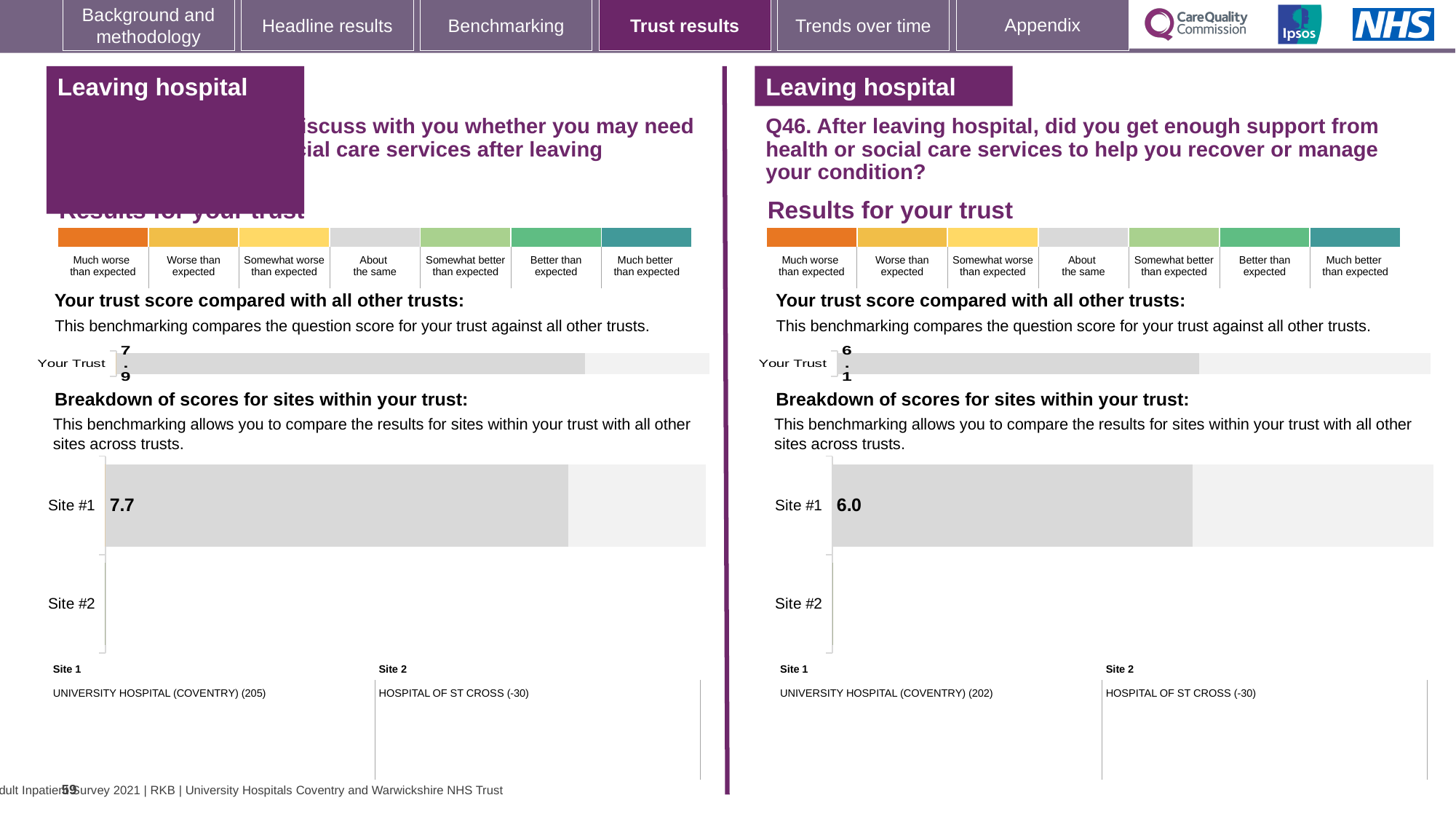
What type of chart is used to show the 'Your Trust' score on the right-hand side for Q46? Bar chart What is the difference between the Site #1 score on the left-hand chart and the Site #1 score on the right-hand chart for Q46? 1.7 On the left-hand site breakdown chart, which site has a bar plotted? Site #1 On the right-hand chart for Q46, what is the 'Your Trust' score? 6.1 Which is larger: the 'Your Trust' score on the left-hand chart or the 'Your Trust' score on the right-hand chart for Q46? Left-hand chart (7.9) On the left-hand chart, what is the 'Your Trust' score? 7.9 What is the difference between the 'Your Trust' score and the Site #1 score on the right-hand chart for Q46? 0.1 What is the difference between the 'Your Trust' score and the Site #1 score on the left-hand chart? 0.2 On the left-hand site breakdown chart, what is the score for Site #1? 7.7 On the right-hand site breakdown chart for Q46, what is the score for Site #1? 6.0 How many sites are listed in the site breakdown chart on the right-hand side for Q46? 2 Which hospital is Site 1 in the right-hand chart for Q46? UNIVERSITY HOSPITAL (COVENTRY)